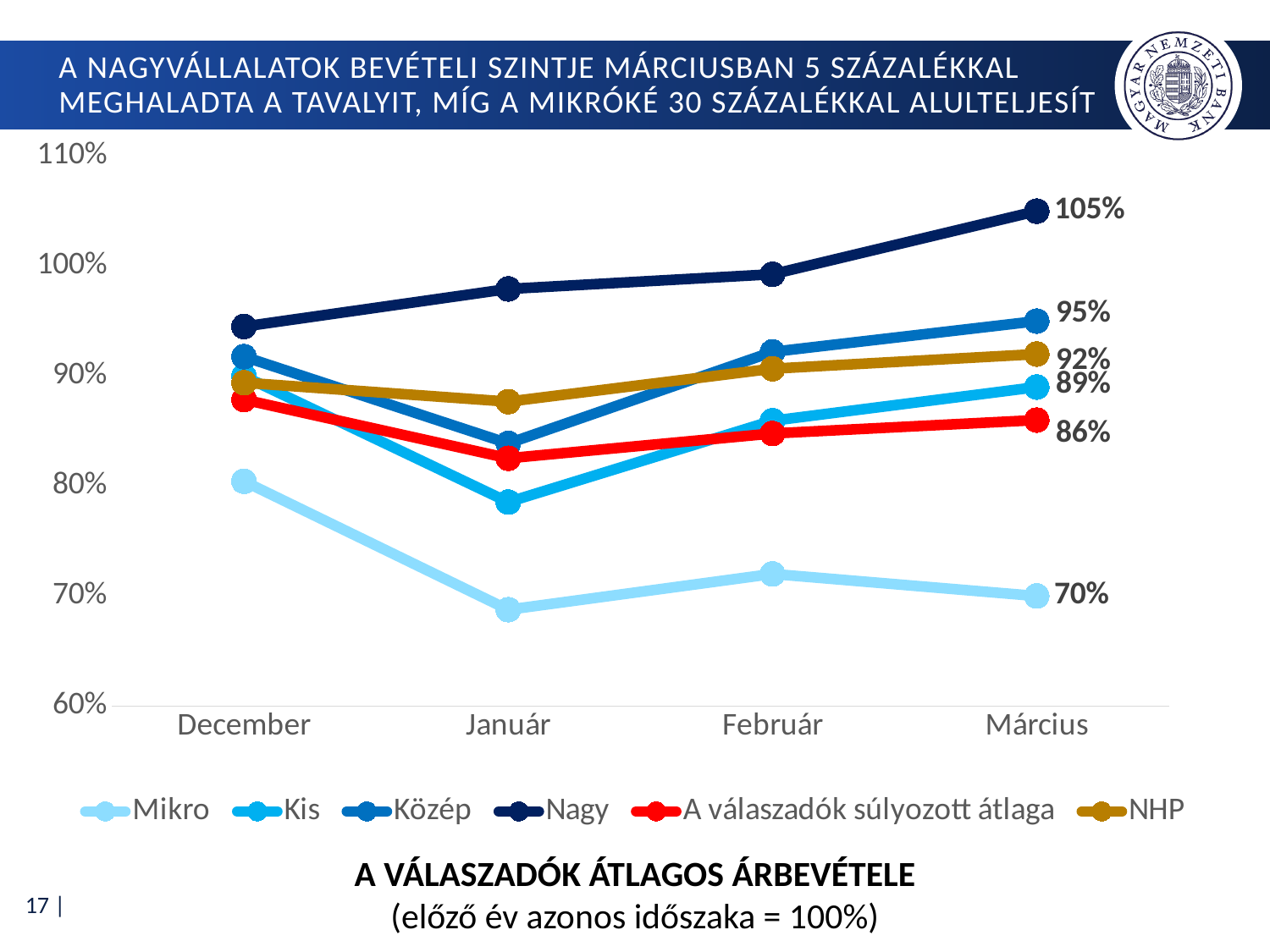
Which series has the highest value in Március? Nagy What is the value for Mikro in Március? 70% What is the value for NHP in Március? 92% What is the difference between the Nagy and Mikro values in Március? 35 percentage points Is the value for Nagy in December greater or less than 90%? greater How many series does the legend list? 6 What is the value for Nagy in Március? 105% Does the Nagy series rise or fall from December to Március? rise What type of chart is shown on the slide? line chart Which series has the lowest value in Március? Mikro What is the value for Közép in Március? 95% How many months are shown on the x axis? 4